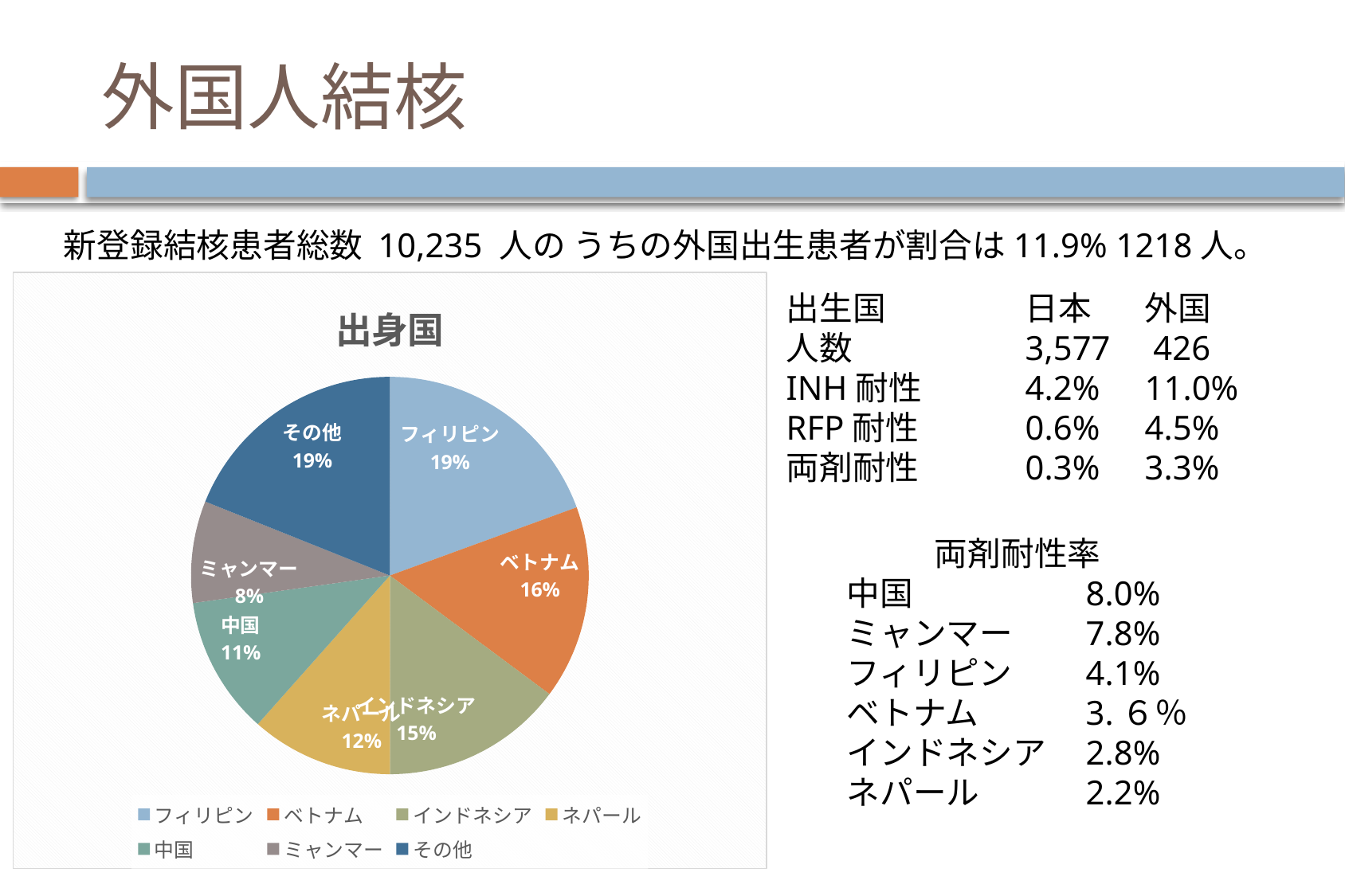
What share of the pie does 中国 have? 11% What share of the pie does フィリピン have? 19% What share of the pie does ベトナム have? 16% Which category has the smallest slice of the pie? ミャンマー How many categories does the pie chart have? 7 What share of the pie does ネパール have? 12% What share of the pie does インドネシア have? 15% What is the difference between the shares of ベトナム and ミャンマー? 8% Which is larger, the share for 中国 or the share for ネパール? ネパール What is the title of the pie chart? 出身国 How many entries does the legend list? 7 What kind of chart is shown on the slide? pie chart